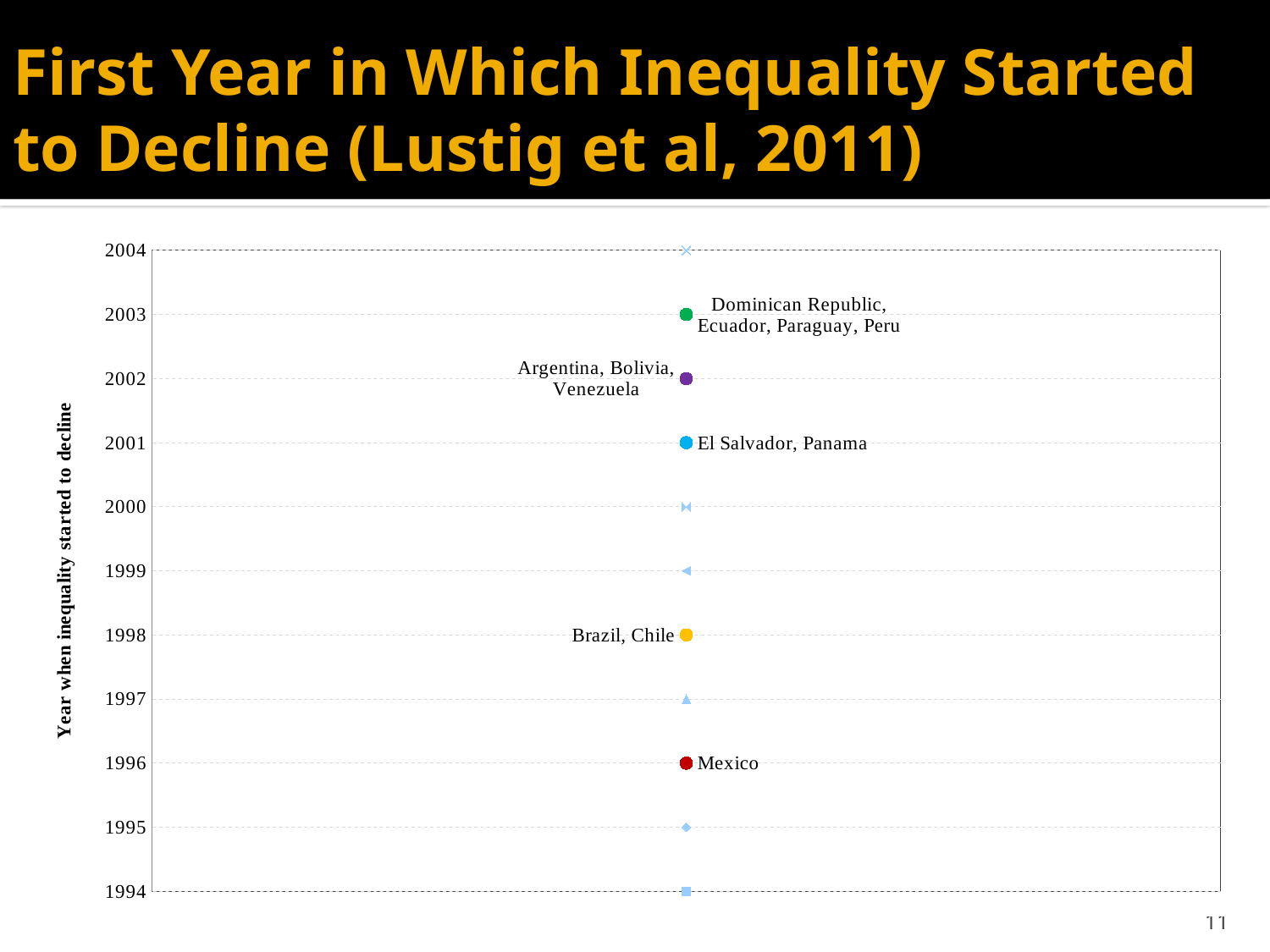
In which year did inequality start to decline in Mexico according to the chart? 1996 What is the label on the vertical axis of the chart? Year when inequality started to decline What year is plotted for Argentina, Bolivia and Venezuela? 2002 How many labelled country groups are shown on the chart? 5 How many years separate the plotted year for El Salvador and Panama from that for the Dominican Republic group? 2 What year is plotted for El Salvador and Panama? 2001 What year is plotted for the Dominican Republic, Ecuador, Paraguay and Peru? 2003 Which labelled country group has the latest year in which inequality started to decline? Dominican Republic, Ecuador, Paraguay, Peru How many years later than Mexico did inequality start to decline in Brazil and Chile? 2 Which started to decline later: inequality in Argentina, Bolivia and Venezuela, or in El Salvador and Panama? Argentina, Bolivia, Venezuela Which labelled country has the earliest year in which inequality started to decline? Mexico What year is plotted for Brazil and Chile? 1998